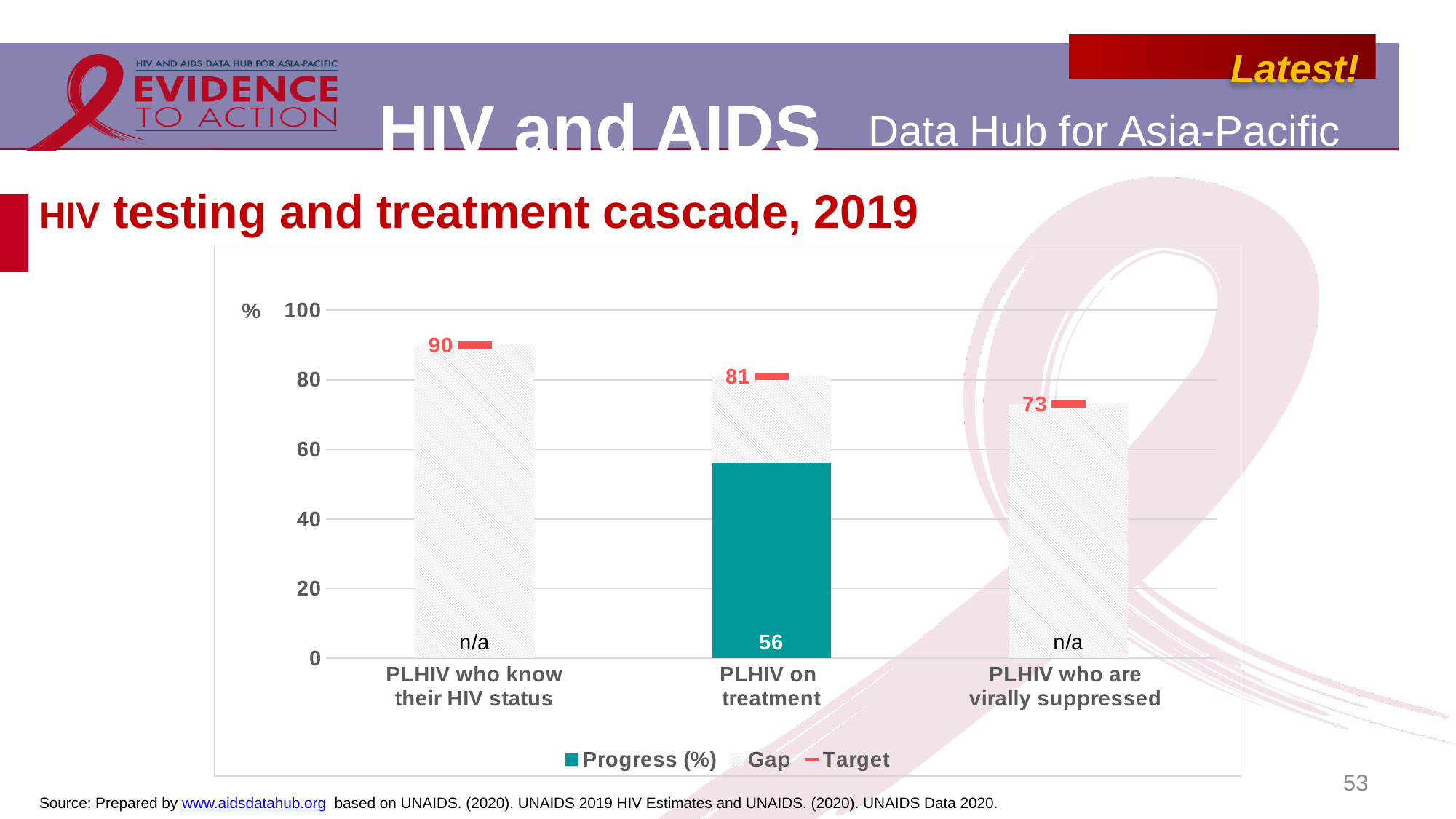
What is the Target value for PLHIV on treatment? 81 How many series does the legend list? 3 What is the Progress (%) value for PLHIV on treatment? 56 What Progress (%) value is shown for PLHIV who are virally suppressed? n/a Which category has the highest Target value? PLHIV who know their HIV status What is the Target value for PLHIV who know their HIV status? 90 How many categories are shown on the x axis? 3 What is the difference between the Target and the Progress (%) value for PLHIV on treatment? 25 What is the Target value for PLHIV who are virally suppressed? 73 What kind of chart is shown on the slide? Bar chart Is the Target value for PLHIV on treatment larger than the Target value for PLHIV who are virally suppressed? Yes Which category has the lowest Target value? PLHIV who are virally suppressed